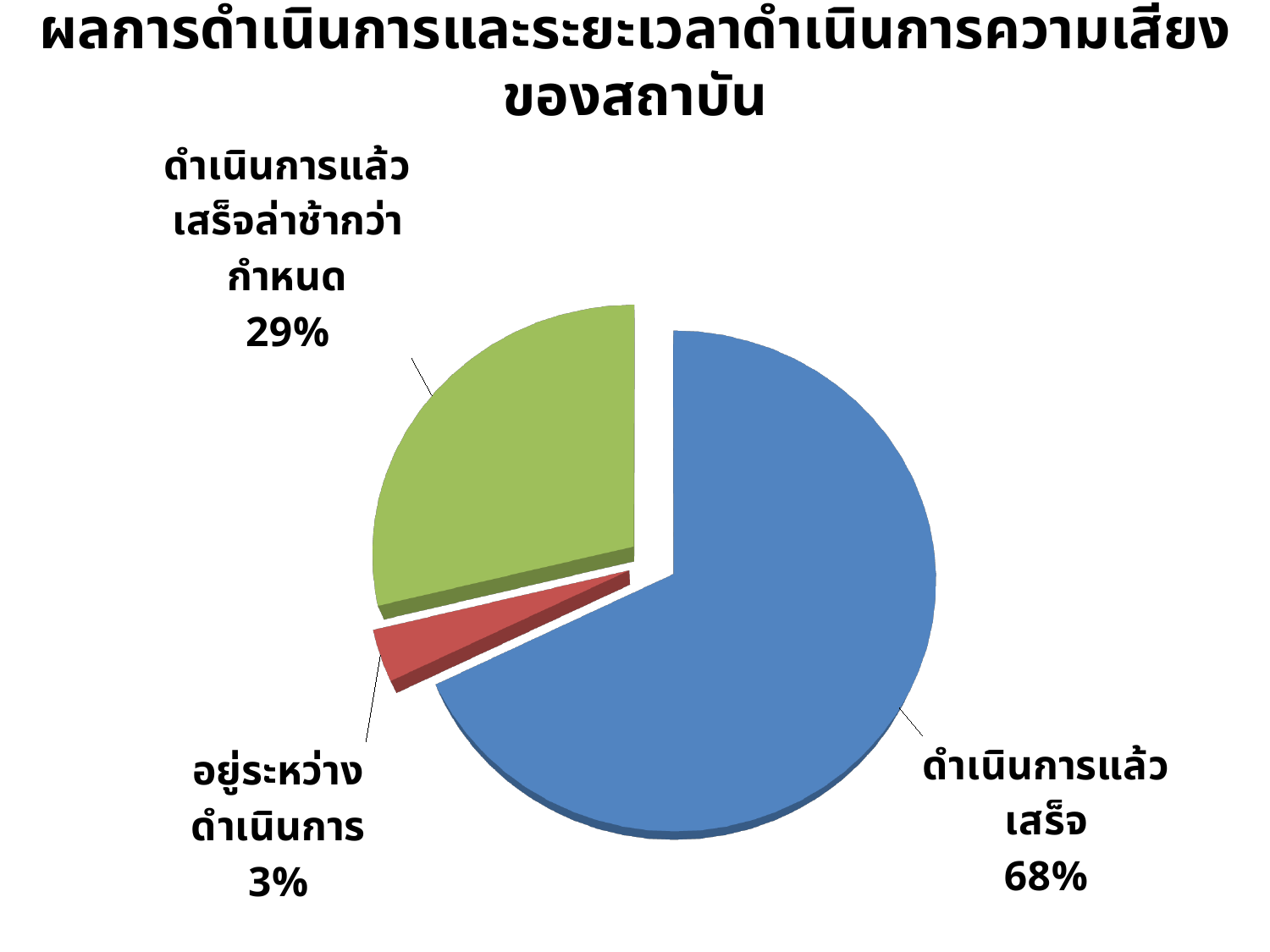
What is the share for ดำเนินการแล้วเสร็จ? 68% What colour is the slice for ดำเนินการแล้วเสร็จ? blue Which is larger, the share for ดำเนินการแล้วเสร็จล่าช้ากว่ากำหนด or the share for อยู่ระหว่างดำเนินการ? ดำเนินการแล้วเสร็จล่าช้ากว่ากำหนด How many slices does the pie chart have? 3 Which category has the largest slice of the pie? ดำเนินการแล้วเสร็จ What is the share for ดำเนินการแล้วเสร็จล่าช้ากว่ากำหนด? 29% What colour is the slice for อยู่ระหว่างดำเนินการ? red What is the share for อยู่ระหว่างดำเนินการ? 3% What kind of chart is shown on the slide? pie chart Which category has the smallest slice of the pie? อยู่ระหว่างดำเนินการ What is the difference in percentage points between ดำเนินการแล้วเสร็จล่าช้ากว่ากำหนด and อยู่ระหว่างดำเนินการ? 26 What is the difference in percentage points between ดำเนินการแล้วเสร็จ and ดำเนินการแล้วเสร็จล่าช้ากว่ากำหนด? 39